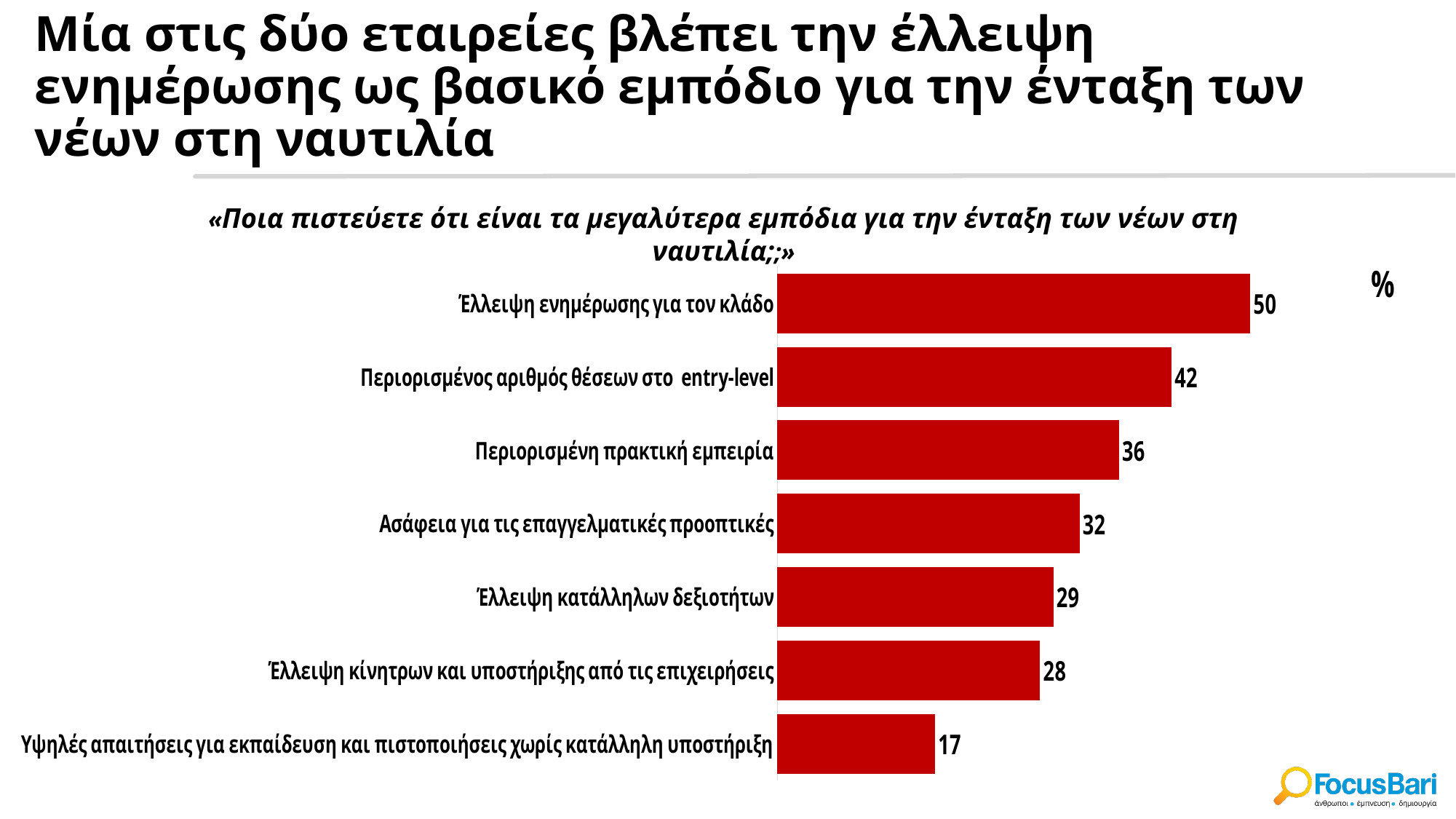
How many categories are shown in the chart? 7 What is the value for 'Περιορισμένη πρακτική εμπειρία'? 36 What kind of chart is shown on the slide? Bar chart What unit is indicated for the values in the chart? % Which is larger: the value for 'Ασάφεια για τις επαγγελματικές προοπτικές' or 'Έλλειψη κατάλληλων δεξιοτήτων'? Ασάφεια για τις επαγγελματικές προοπτικές Which category has the highest value? Έλλειψη ενημέρωσης για τον κλάδο What is the value for 'Έλλειψη ενημέρωσης για τον κλάδο'? 50 Which category has the lowest value? Υψηλές απαιτήσεις για εκπαίδευση και πιστοποιήσεις χωρίς κατάλληλη υποστήριξη What is the difference between the values for 'Έλλειψη ενημέρωσης για τον κλάδο' and 'Περιορισμένος αριθμός θέσεων στο entry-level'? 8 What is the value for 'Υψηλές απαιτήσεις για εκπαίδευση και πιστοποιήσεις χωρίς κατάλληλη υποστήριξη'? 17 What is the value for 'Έλλειψη κίνητρων και υποστήριξης από τις επιχειρήσεις'? 28 What colour are the bars in the chart? Red